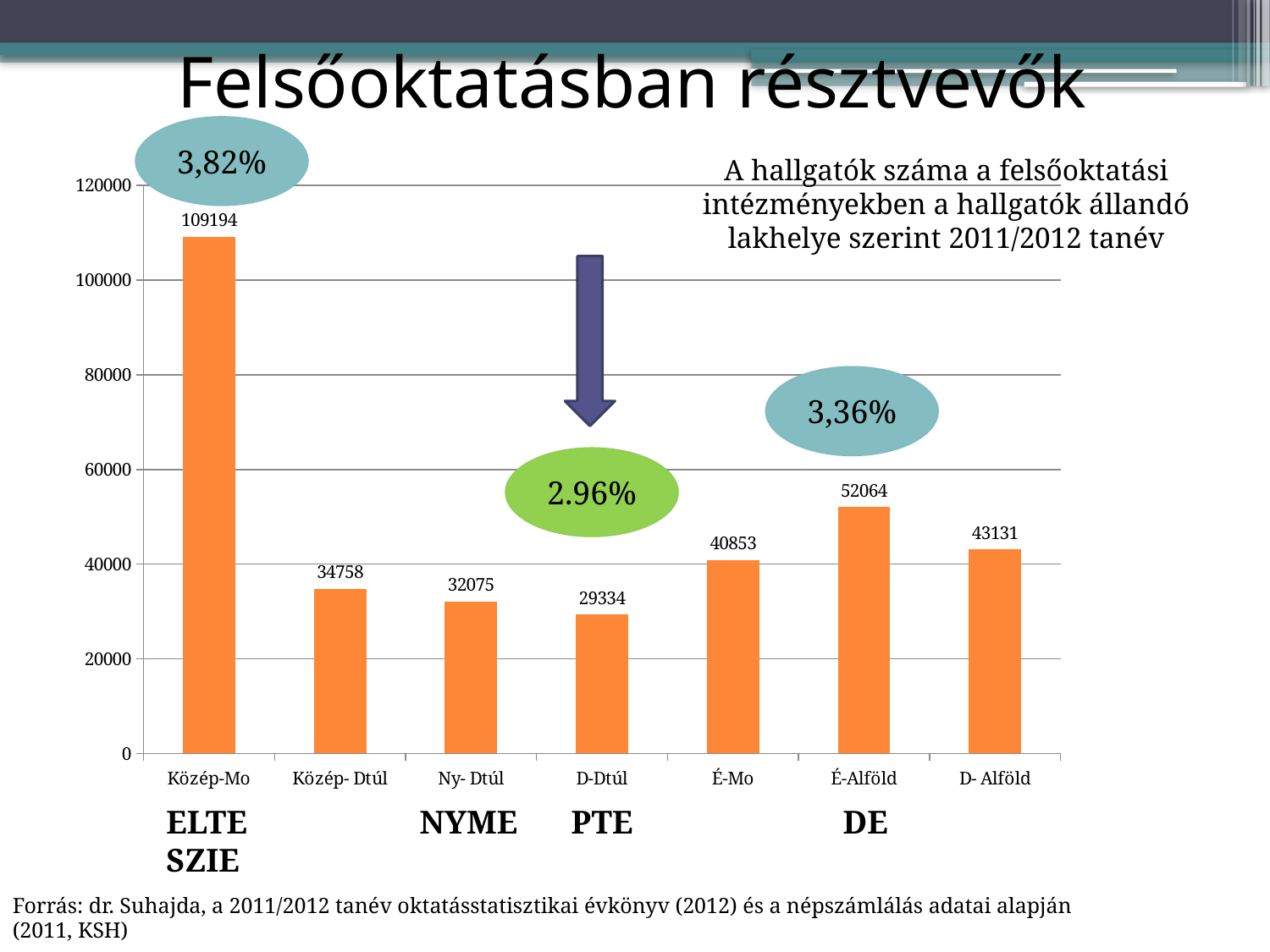
How many categories are shown on the x axis? 7 What is the value for É-Alföld? 52064 What kind of chart is shown on the slide? bar chart What is the value for Közép-Mo? 109194 What is the difference between the values for É-Alföld and D-Alföld? 8933 What is the value for D-Dtúl? 29334 Which is larger, the value for É-Mo or the value for Közép-Dtúl? É-Mo What percentage is shown in the green oval above the D-Dtúl bar? 2.96% What is the value for Ny-Dtúl? 32075 Which category has the lowest value? D-Dtúl Which category has the highest value? Közép-Mo Is the value for D-Alföld greater or less than 40000? greater